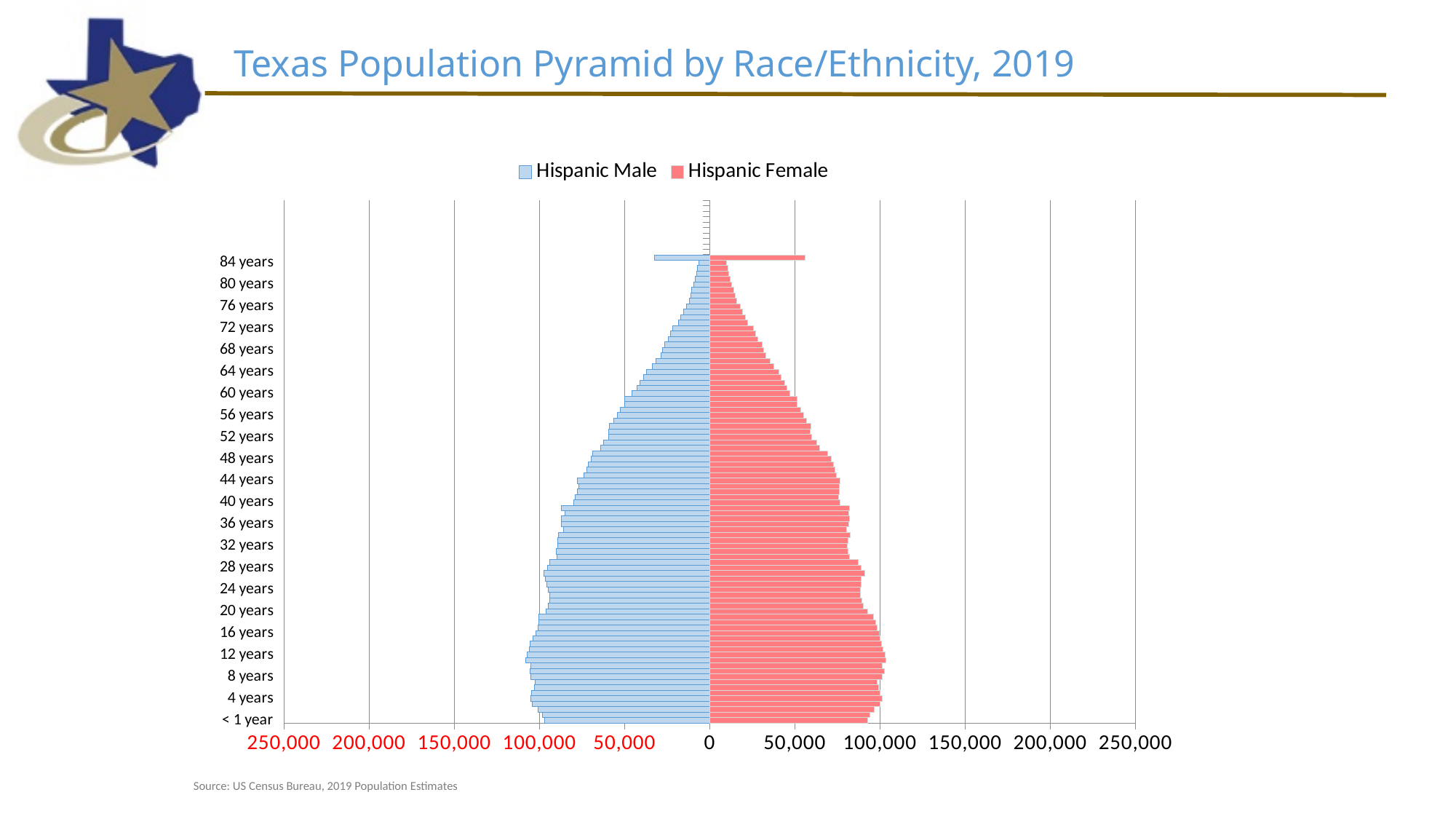
What are the two series named in the legend? Hispanic Male and Hispanic Female How many age labels are shown on the vertical axis? 22 Which colour represents Hispanic Female in the chart? Red/pink What kind of chart is shown on the slide? Bar chart (population pyramid) Is the value for Hispanic Female at 40 years greater or less than 100,000? less Is the value for Hispanic Male at 12 years greater or less than 100,000? greater At 84 years, which is larger, the Hispanic Male value or the Hispanic Female value? Hispanic Female Is the value for Hispanic Male at 84 years greater or less than 50,000? less How many series does the legend list? 2 Moving from 84 years down to 12 years, do the Hispanic Male bars generally get longer or shorter? longer